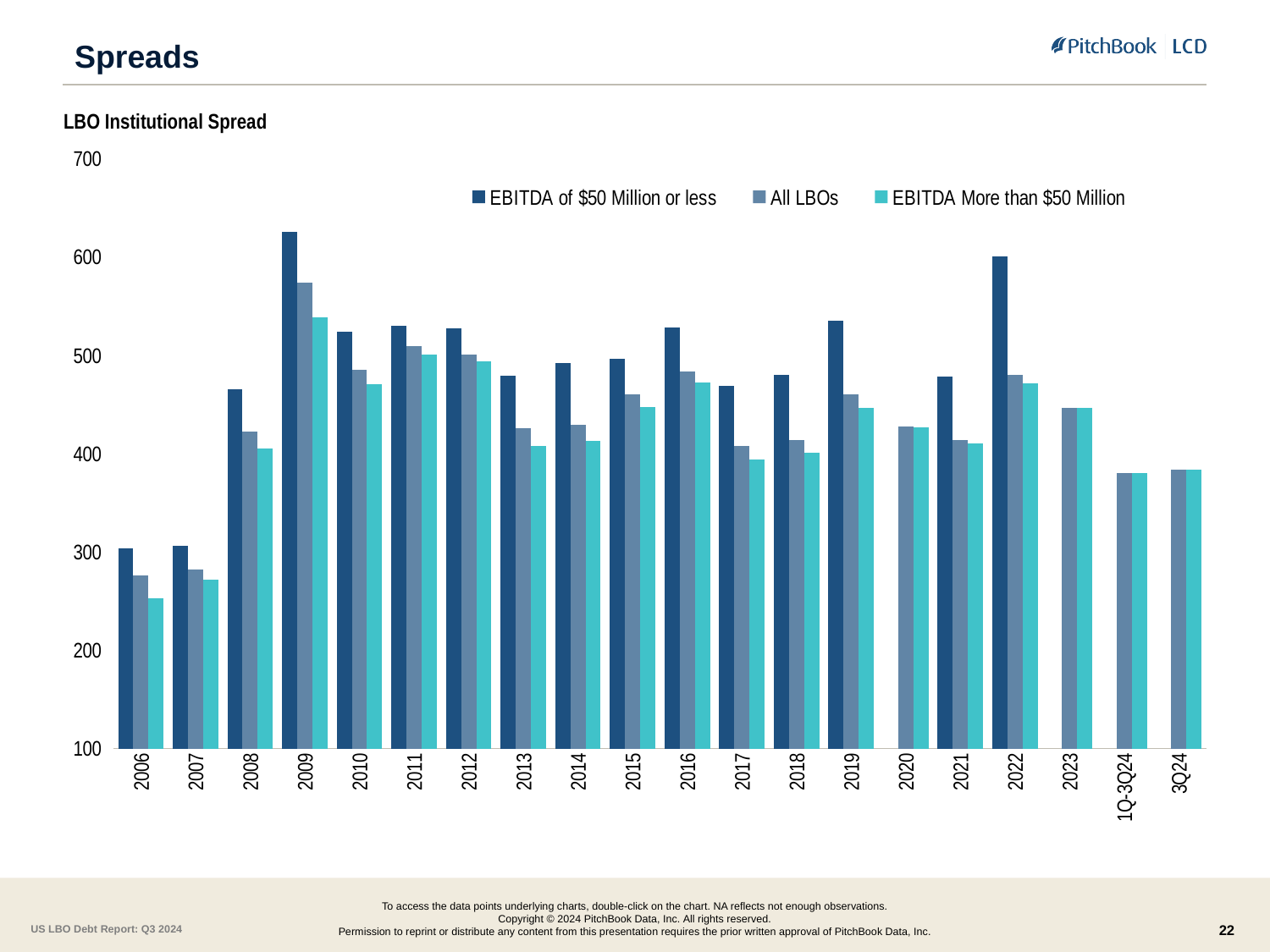
In which year is the value for All LBOs highest? 2009 Is the value for EBITDA of $50 Million or less in 2009 greater or less than 600? greater In 2019, which is larger: EBITDA of $50 Million or less or EBITDA More than $50 Million? EBITDA of $50 Million or less Is the value for All LBOs in 3Q24 greater or less than 400? less Is the value for All LBOs in 2006 greater or less than 300? less What kind of chart is shown on the slide? bar chart In which year is the value for EBITDA More than $50 Million lowest? 2006 What is the title of the chart? LBO Institutional Spread How many categories are shown along the x axis? 20 Does the value for EBITDA of $50 Million or less rise or fall from 2006 to 2009? rise How many series does the legend list? 3 In which year is the value for EBITDA of $50 Million or less highest? 2009